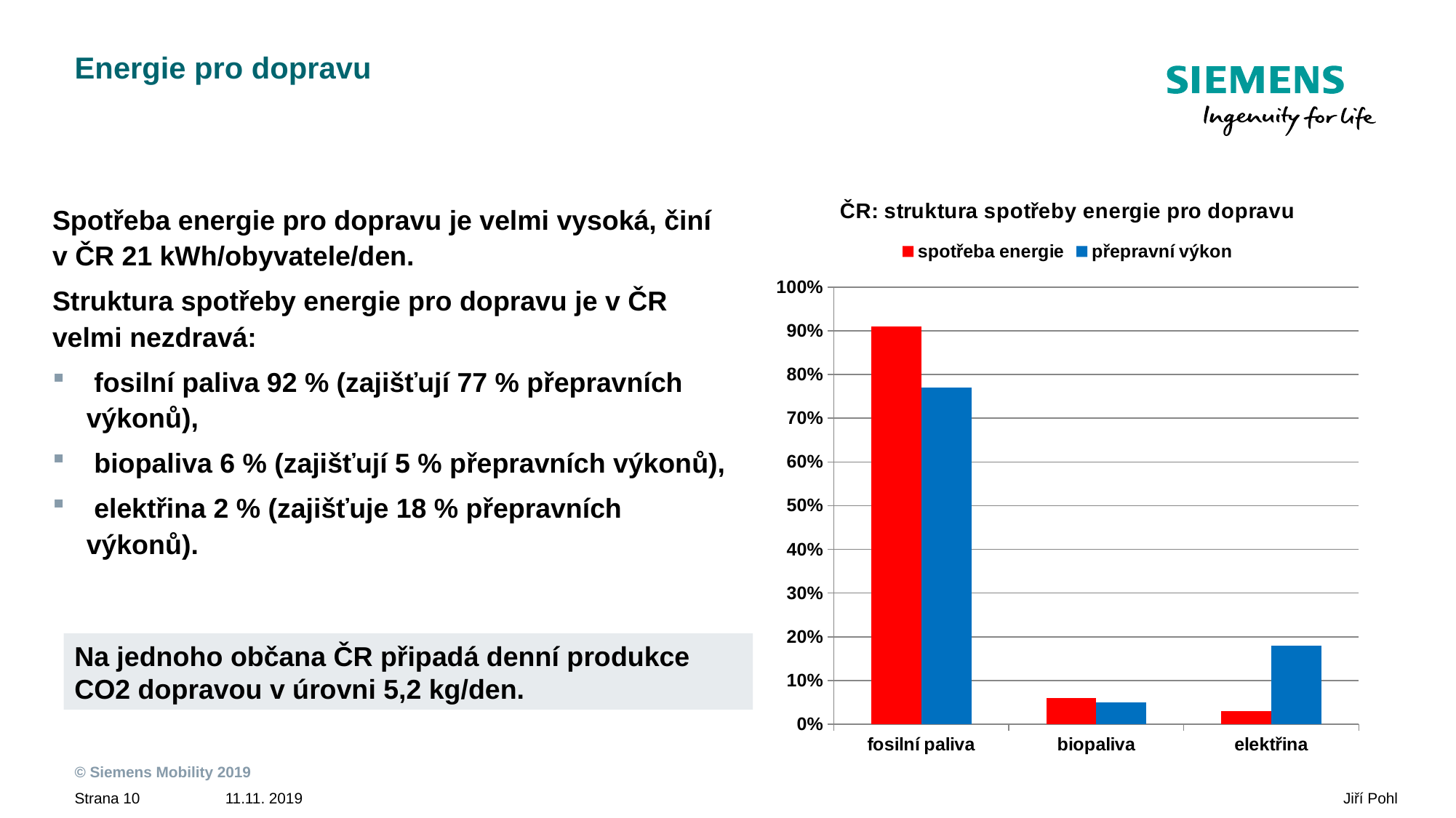
What is the title of the chart? ČR: struktura spotřeby energie pro dopravu How many series does the chart legend list? 2 For 'fosilní paliva', which is larger: 'spotřeba energie' or 'přepravní výkon'? spotřeba energie Is the 'spotřeba energie' value for 'fosilní paliva' greater or less than 80%? greater Which category has the lowest value for 'spotřeba energie'? elektřina For 'elektřina', which is larger: 'spotřeba energie' or 'přepravní výkon'? přepravní výkon What kind of chart is shown on the slide? bar chart Is the 'přepravní výkon' value for 'elektřina' greater or less than 10%? greater Which colour represents the series 'přepravní výkon' in the chart? blue Which category has the lowest value for 'přepravní výkon'? biopaliva Which category has the highest value for 'spotřeba energie'? fosilní paliva How many categories are shown on the x axis of the chart? 3